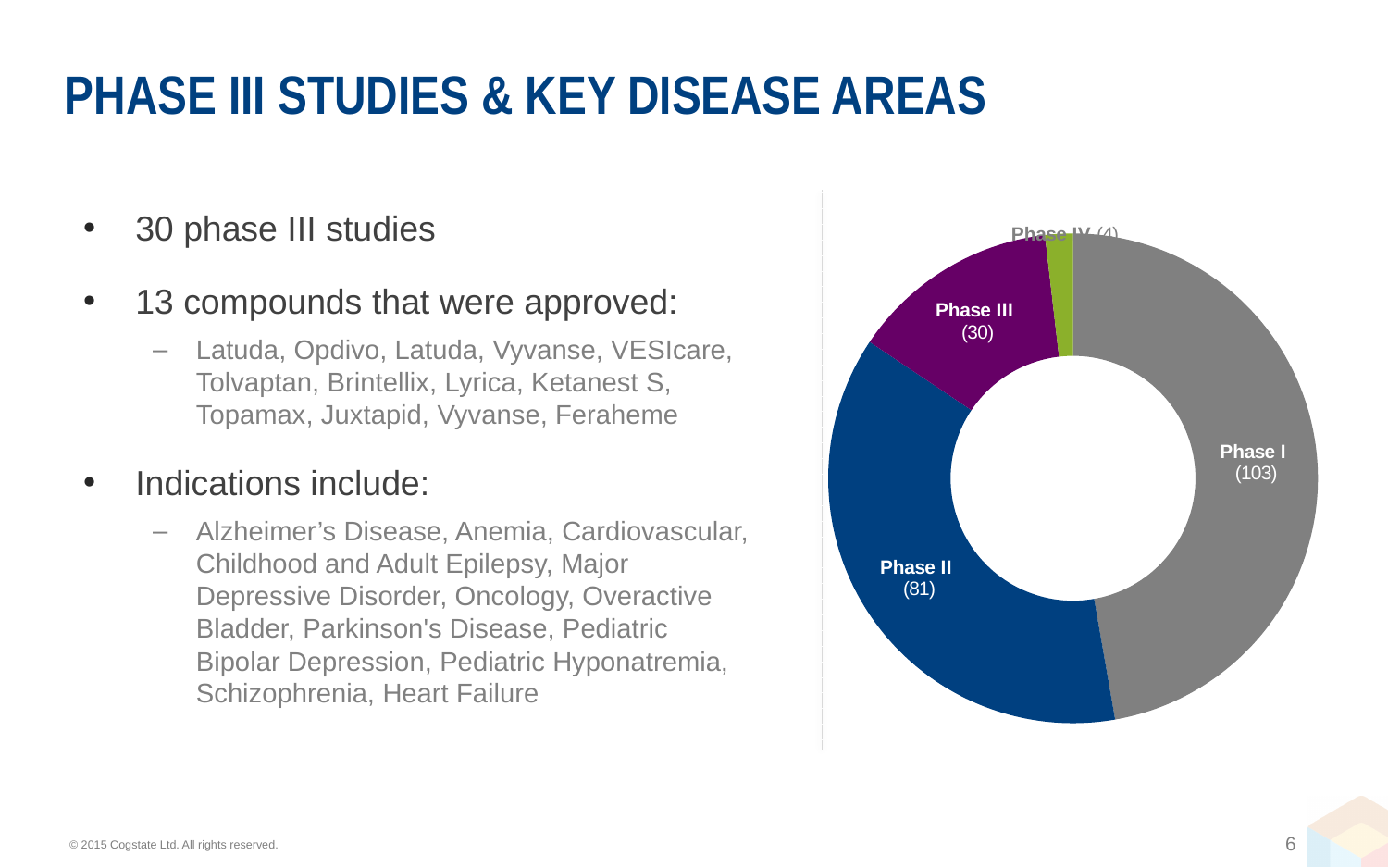
What is the total of all the values shown in the chart? 218 What is the difference between the Phase II and Phase III values? 51 What type of chart is shown on the slide? Pie chart (donut) How many studies are shown for Phase II? 81 How many studies are shown for Phase IV? 4 Which is larger, the value for Phase II or the value for Phase III? Phase II How many phases (slices) are shown in the chart? 4 How many studies are shown for Phase III? 30 What is the difference between the Phase I and Phase II values? 22 How many studies are shown for Phase I? 103 Which phase has the smallest slice of the chart? Phase IV Which phase has the largest slice of the chart? Phase I